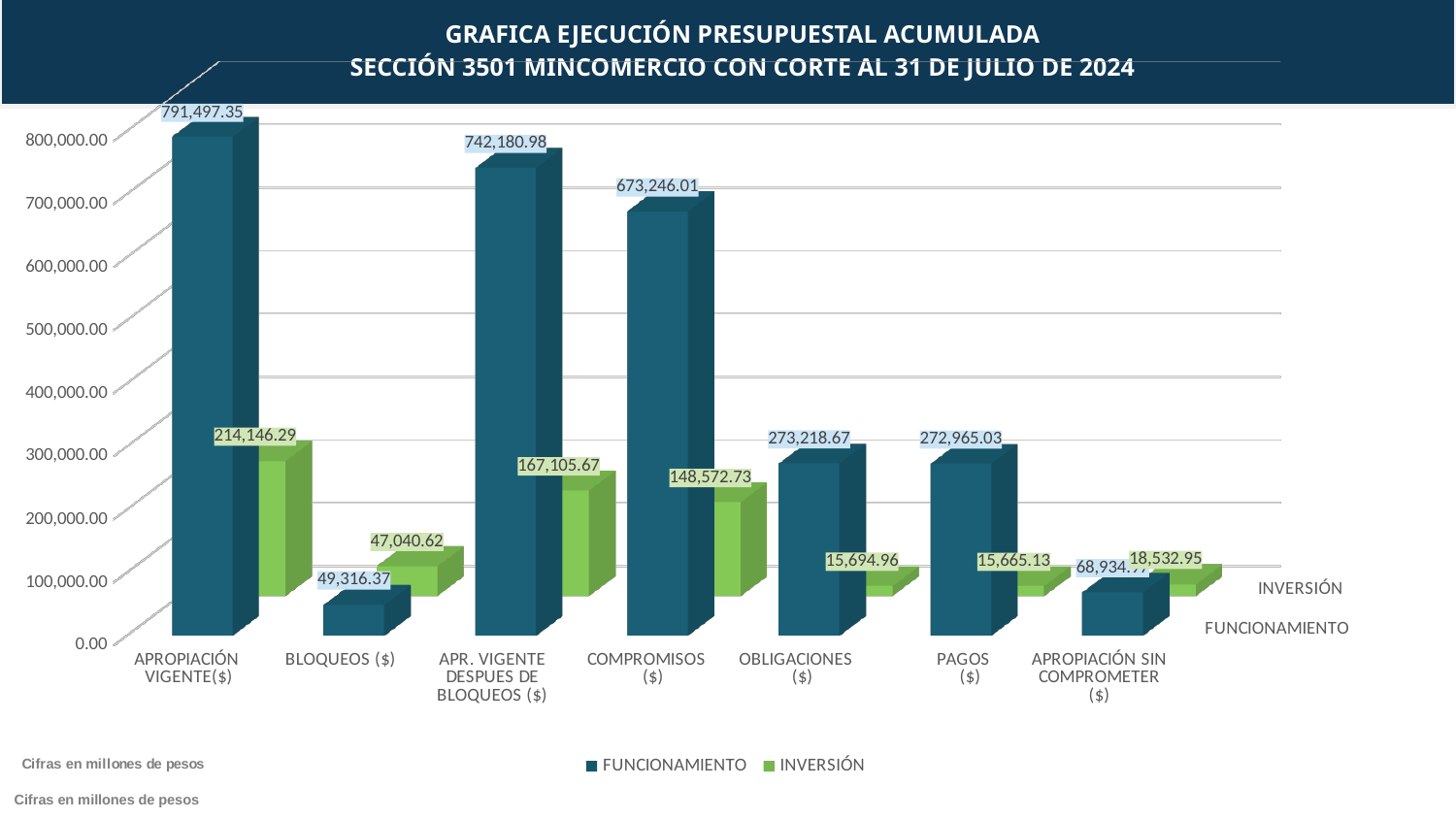
How many categories are shown on the x axis? 7 Which is larger, the INVERSIÓN value for APROPIACIÓN VIGENTE($) or the INVERSIÓN value for APR. VIGENTE DESPUES DE BLOQUEOS ($)? APROPIACIÓN VIGENTE($) What is the FUNCIONAMIENTO value for PAGOS ($)? 272,965.03 What is the INVERSIÓN value for COMPROMISOS ($)? 148,572.73 Which category has the lowest FUNCIONAMIENTO value? BLOQUEOS ($) What is the difference between the FUNCIONAMIENTO values for APROPIACIÓN VIGENTE($) and APR. VIGENTE DESPUES DE BLOQUEOS ($)? 49,316.37 Is the FUNCIONAMIENTO value for COMPROMISOS ($) greater or less than 600,000.00? greater What is the INVERSIÓN value for BLOQUEOS ($)? 47,040.62 How many series does the legend list? 2 What kind of chart is shown on the slide? bar chart What is the FUNCIONAMIENTO value for APROPIACIÓN VIGENTE($)? 791,497.35 Which category has the highest FUNCIONAMIENTO value? APROPIACIÓN VIGENTE($)